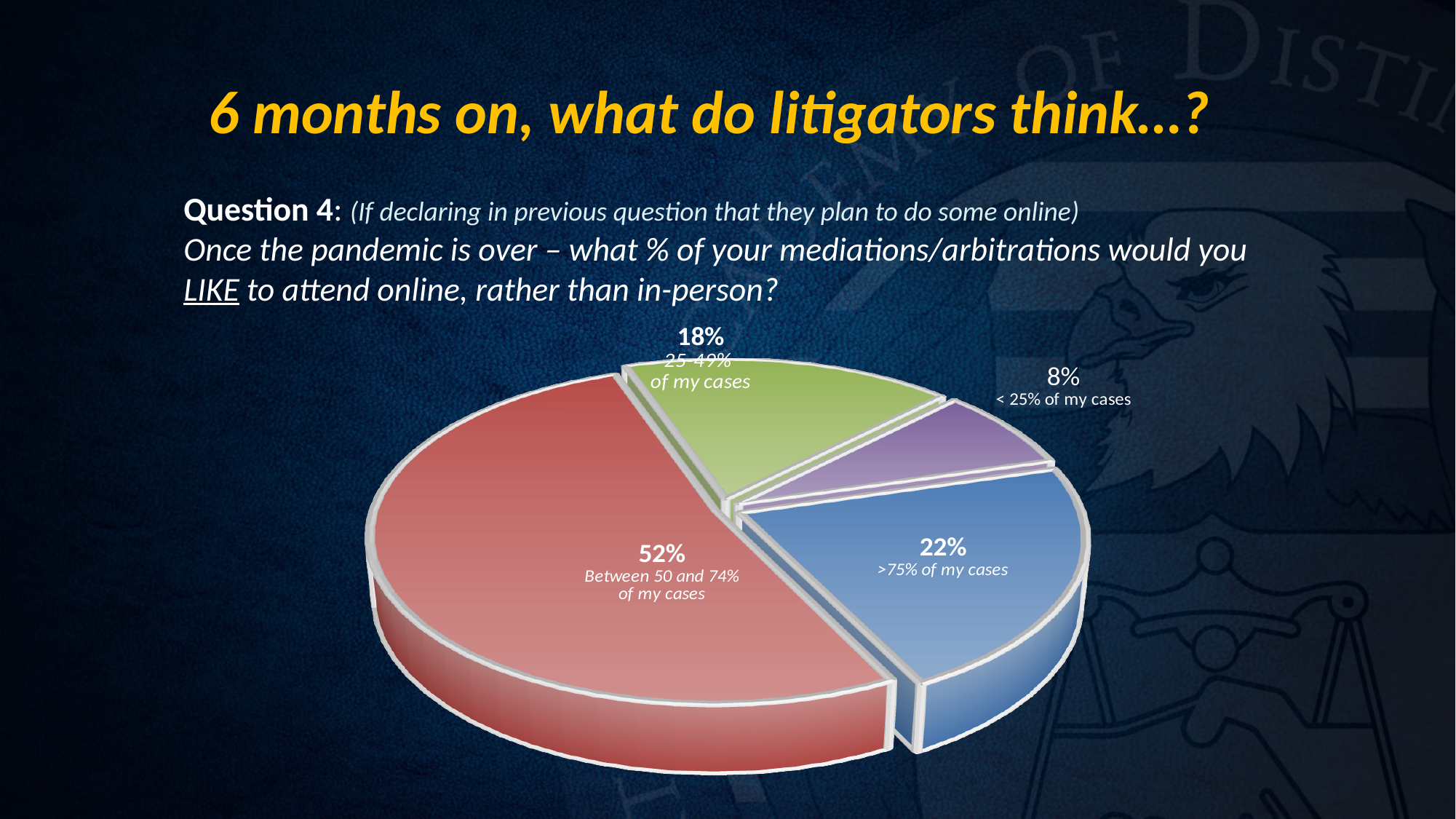
What share of respondents said they would like to attend >75% of their cases online? 22% How many slices does the pie chart have? 4 Which is larger: the share for '25-49% of my cases' or the share for '< 25% of my cases'? 25-49% of my cases What share of respondents said they would like to attend between 50 and 74% of their cases online? 52% What is the difference in percentage points between the 'Between 50 and 74% of my cases' slice and the '>75% of my cases' slice? 30 What colour is the slice representing '>75% of my cases'? blue What colour is the slice representing 'Between 50 and 74% of my cases'? red What share of respondents chose 25-49% of my cases? 18% What share of respondents chose < 25% of my cases? 8% Which category has the largest slice of the pie? Between 50 and 74% of my cases What kind of chart is shown on the slide? pie chart Which category has the smallest slice of the pie? < 25% of my cases